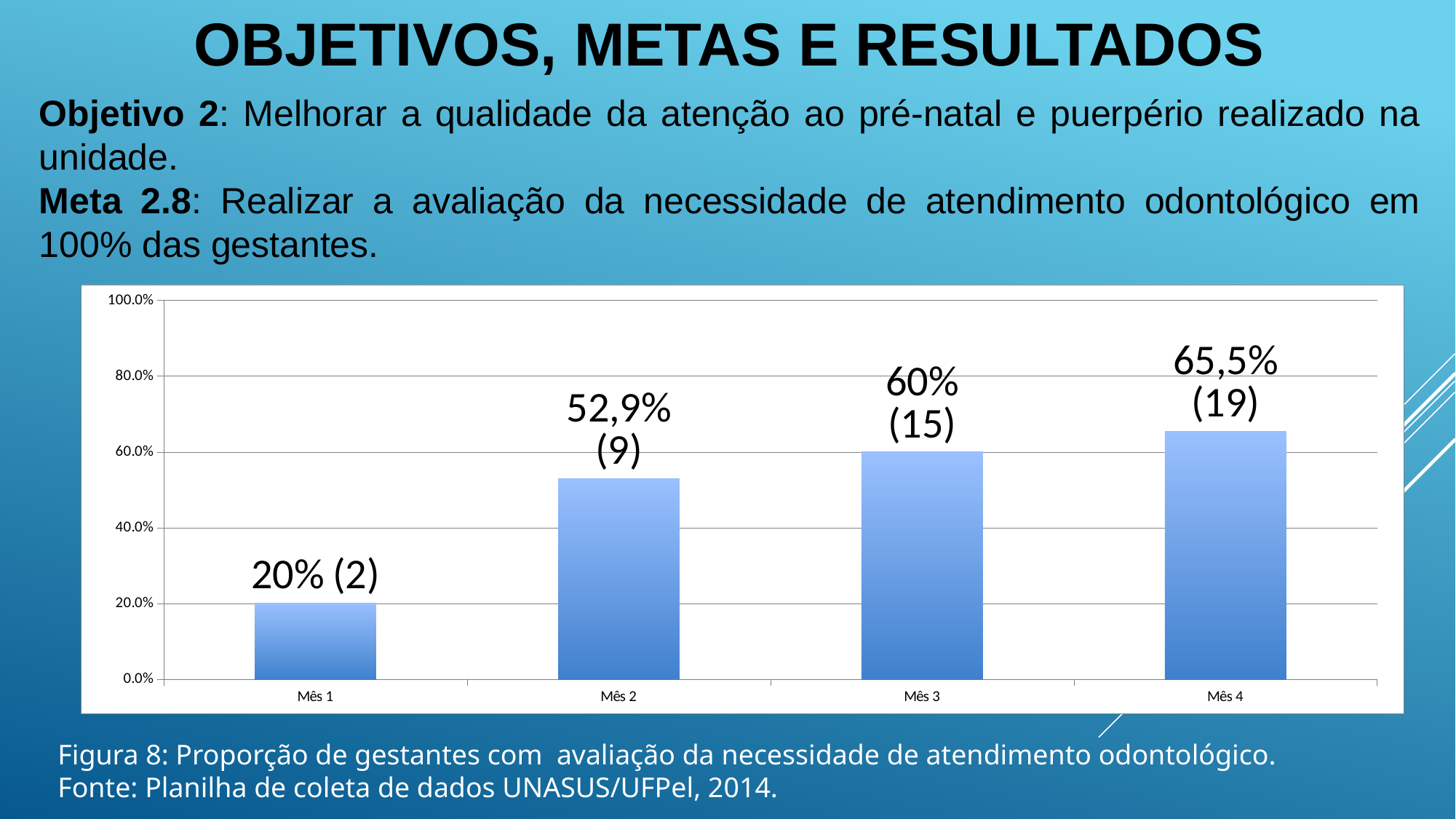
Do the values rise or fall from Mês 1 to Mês 4? Rise Which month has the highest value? Mês 4 What is the value shown for Mês 2? 52,9% (9) What is the value shown for Mês 4? 65,5% (19) Which is larger, the value for Mês 2 or the value for Mês 3? Mês 3 Which month has the lowest value? Mês 1 What is the value shown for Mês 3? 60% (15) What is the value shown for Mês 1? 20% (2) How many months are shown on the x axis? 4 What kind of chart is shown on the slide? Bar chart Is the value for Mês 2 greater or less than 40.0%? greater What is the figure caption below the chart? Figura 8: Proporção de gestantes com avaliação da necessidade de atendimento odontológico.